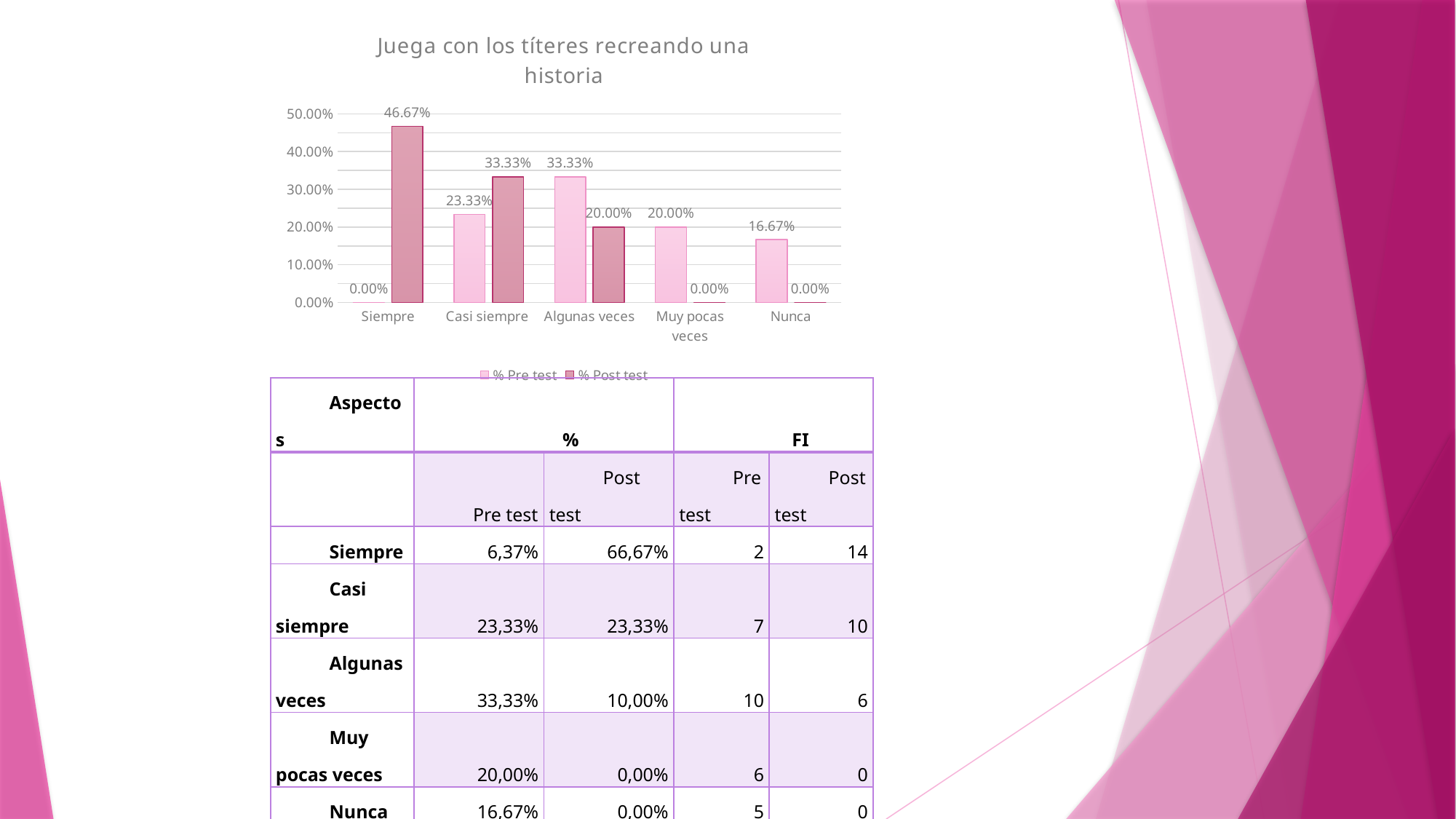
What type of chart is shown on the slide? Bar chart What is the % Pre test value for Algunas veces in the chart? 33.33% Which category has the highest % Post test value in the chart? Siempre What is the % Pre test value for Nunca in the chart? 16.67% How many series does the chart's legend list? 2 In the chart, which is larger for Algunas veces: the % Pre test value or the % Post test value? % Pre test What is the % Post test value for Muy pocas veces in the chart? 0.00% Which category has the lowest % Pre test value in the chart? Siempre In the chart, what is the difference between the % Post test and % Pre test values for Casi siempre? 10.00% How many categories are shown on the x axis of the chart? 5 Is the % Post test value for Siempre in the chart greater or less than 40.00%? greater What is the % Post test value for Siempre in the chart? 46.67%